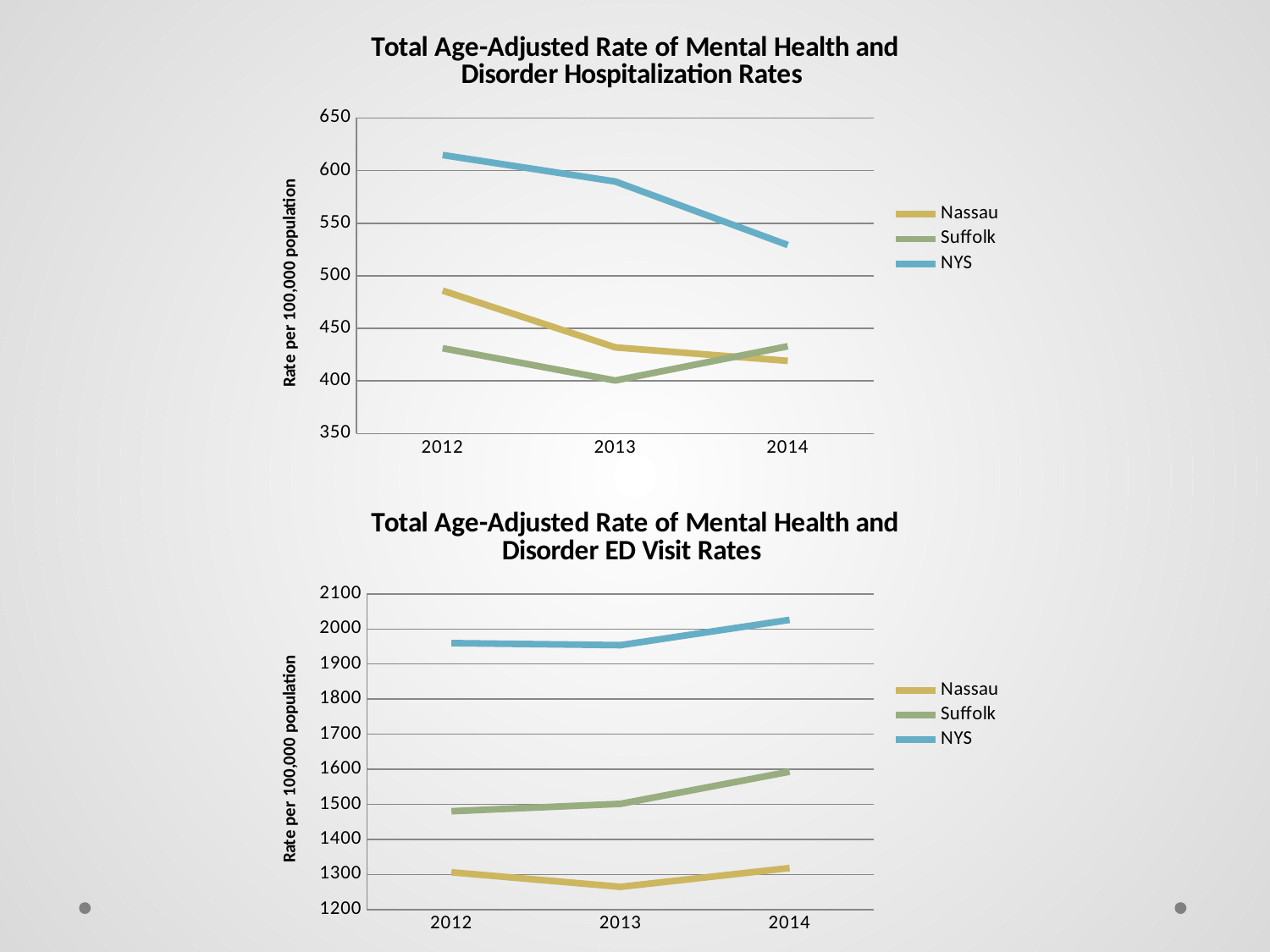
How many years are shown on the x axis of the 'Total Age-Adjusted Rate of Mental Health and Disorder Hospitalization Rates' chart? 3 In the 'Total Age-Adjusted Rate of Mental Health and Disorder Hospitalization Rates' chart, which series has the highest value in 2012? NYS In the 'Total Age-Adjusted Rate of Mental Health and Disorder Hospitalization Rates' chart, is the NYS value for 2012 greater or less than 600? greater How many series does the legend list in the 'Total Age-Adjusted Rate of Mental Health and Disorder ED Visit Rates' chart? 3 In the 'Total Age-Adjusted Rate of Mental Health and Disorder ED Visit Rates' chart, is the NYS value for 2014 greater or less than 2000? greater In the 'Total Age-Adjusted Rate of Mental Health and Disorder ED Visit Rates' chart, which series has the lowest value in 2014? Nassau In the 'Total Age-Adjusted Rate of Mental Health and Disorder ED Visit Rates' chart, is the Nassau value for 2013 greater or less than 1300? less In the 'Total Age-Adjusted Rate of Mental Health and Disorder ED Visit Rates' chart, does the Suffolk line rise or fall from 2012 to 2014? Rise In the 'Total Age-Adjusted Rate of Mental Health and Disorder Hospitalization Rates' chart, does the NYS line rise or fall from 2012 to 2014? Fall What type of chart is the 'Total Age-Adjusted Rate of Mental Health and Disorder Hospitalization Rates' chart? Line chart In the 'Total Age-Adjusted Rate of Mental Health and Disorder Hospitalization Rates' chart, which is larger in 2012, Nassau or Suffolk? Nassau